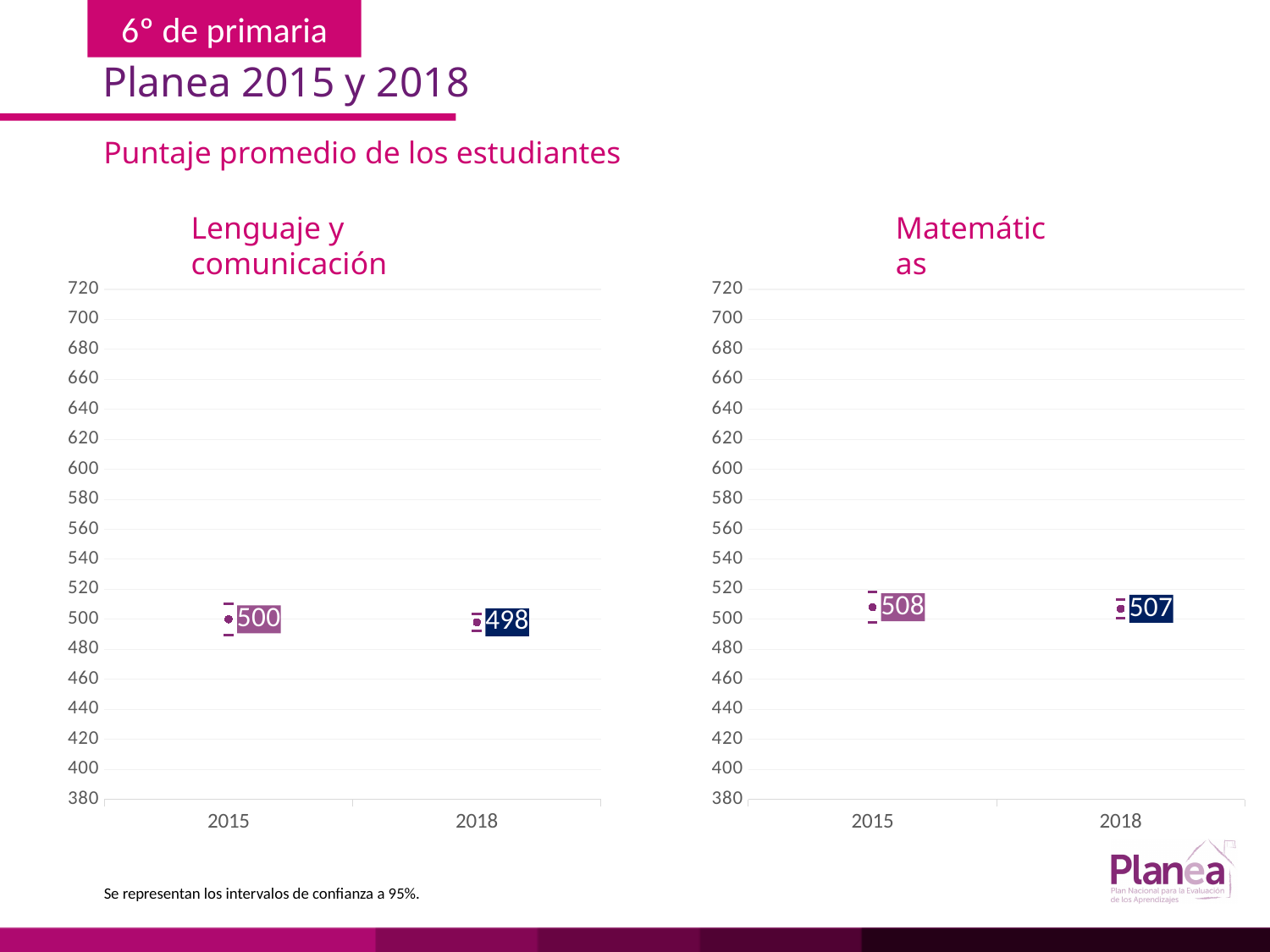
In the Lenguaje y comunicación chart, what is the average score for 2015? 500 In the Matemáticas chart, what is the difference between the 2015 and 2018 scores? 1 In the Matemáticas chart, what is the average score for 2018? 507 In the Matemáticas chart, do the scores rise or fall from 2015 to 2018? fall In the Lenguaje y comunicación chart, what is the difference between the 2015 and 2018 scores? 2 In the Matemáticas chart, how many data points are plotted? 2 In the Lenguaje y comunicación chart, what is the average score for 2018? 498 In the Lenguaje y comunicación chart, how many years are plotted on the x axis? 2 What is the lowest value shown on the y axis of the Lenguaje y comunicación chart? 380 In the Lenguaje y comunicación chart, do the scores rise or fall from 2015 to 2018? fall What is the title of the chart on the right side of the slide? Matemáticas In the Matemáticas chart, what is the average score for 2015? 508